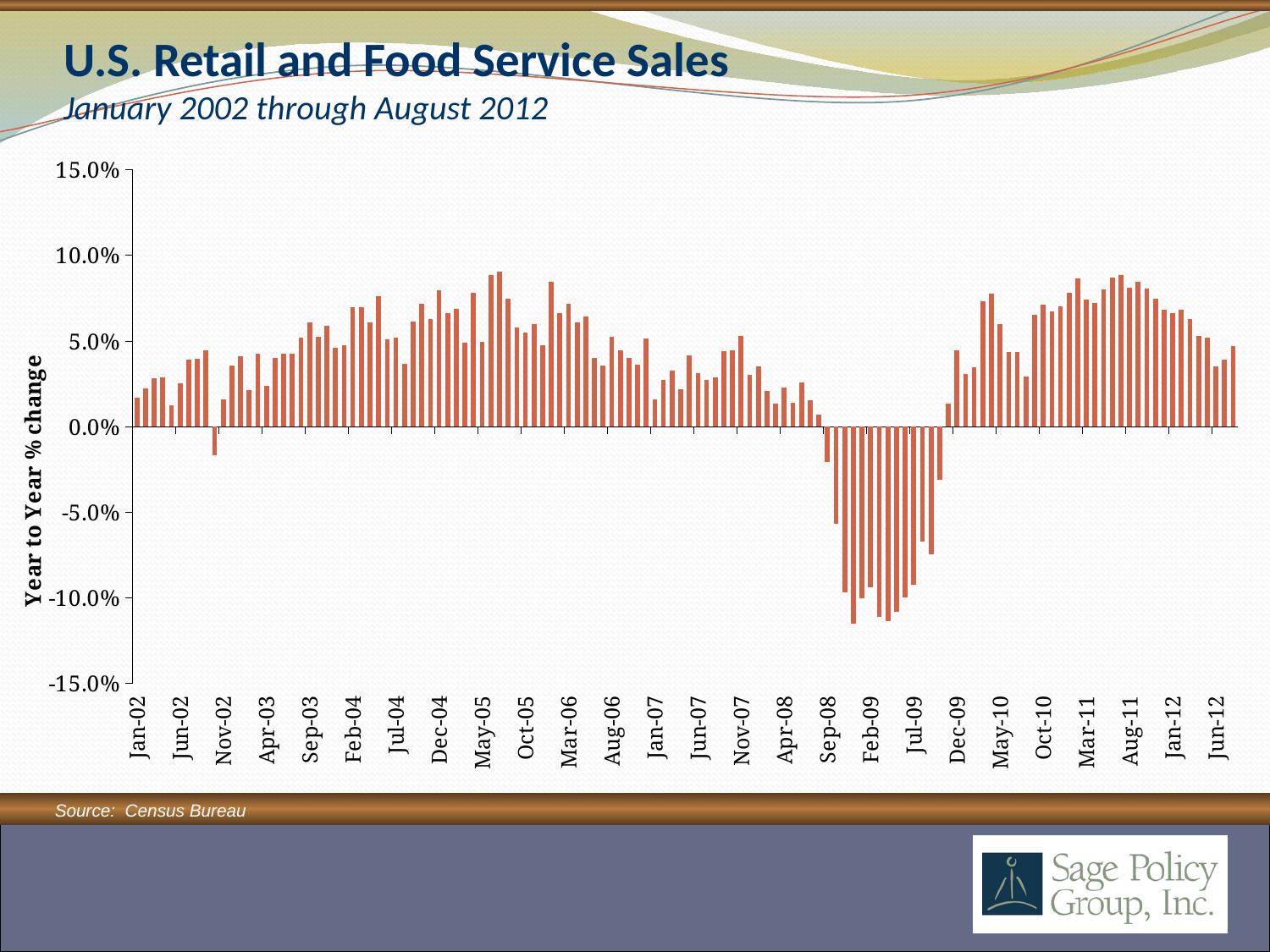
What is the label on the vertical axis of the chart? Year to Year % change Is the value for Jul-09 greater or less than 0.0%? less Do the values rise or fall from Sep-08 to Feb-09? fall Which has the larger value, Jun-02 or Jul-09? Jun-02 Is the value for Aug-11 greater or less than 5.0%? greater Do the values rise or fall from Jul-09 to Dec-09? rise Which has the larger value, Feb-09 or Aug-11? Aug-11 Is the value for Jan-02 greater or less than 5.0%? less What is the title of the chart? U.S. Retail and Food Service Sales What kind of chart is shown on the slide? bar chart